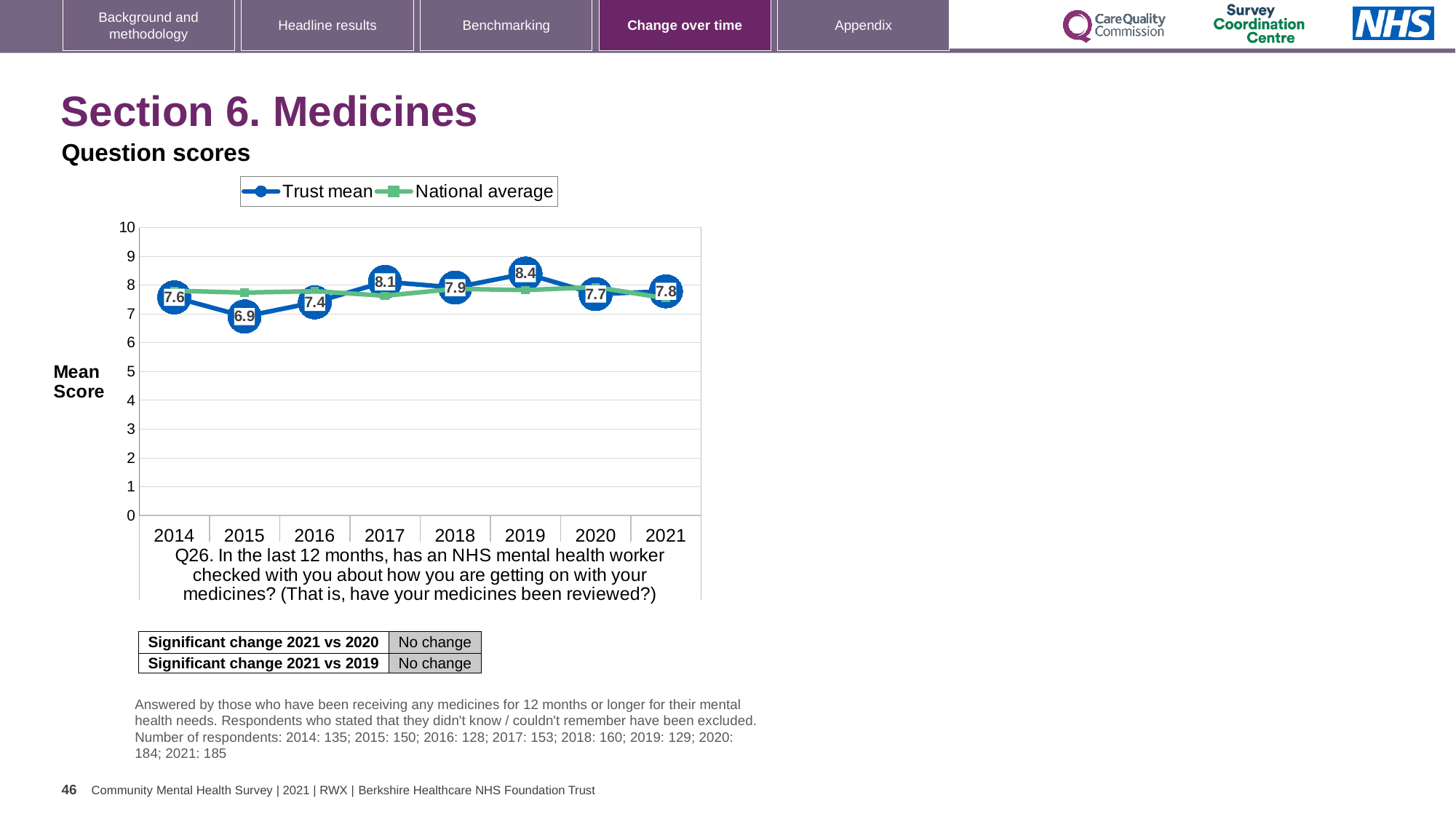
Is the National average value for 2015 greater or less than 7? greater What kind of chart is shown on the slide? line chart In which year is the Trust mean score highest? 2019 In which year is the Trust mean score lowest? 2015 How many series does the legend list? 2 What is the Trust mean score for 2019? 8.4 Which year has the larger Trust mean score, 2017 or 2016? 2017 Which series is shown in green in the legend? National average How many years are shown on the x axis? 8 What is the Trust mean score for 2021? 7.8 What is the Trust mean score for 2015? 6.9 What is the difference between the Trust mean scores for 2019 and 2015? 1.5